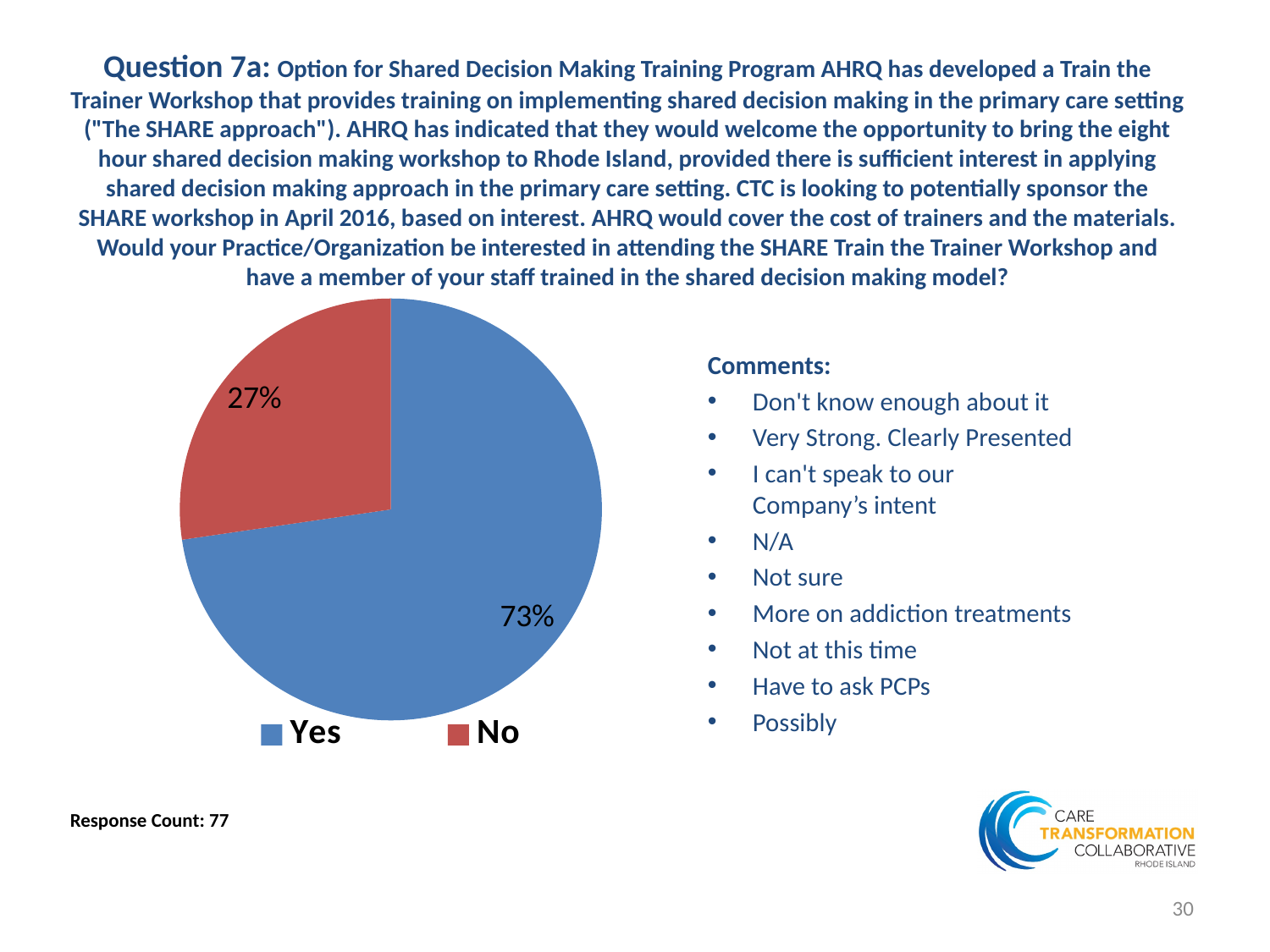
What percentage of respondents answered Yes? 73% How many slices does the pie chart have? 2 How many entries does the legend list? 2 Which response has the largest share of the pie? Yes What share of the pie does the Yes slice represent? 73% What is the difference in percentage points between the Yes and No shares? 46 What colour is the No slice in the pie chart? Red What is the response count shown on the slide? 77 What percentage of respondents answered No? 27% Which response has the smallest share of the pie? No What type of chart is shown on the slide? Pie chart Which is larger, the Yes share or the No share? Yes